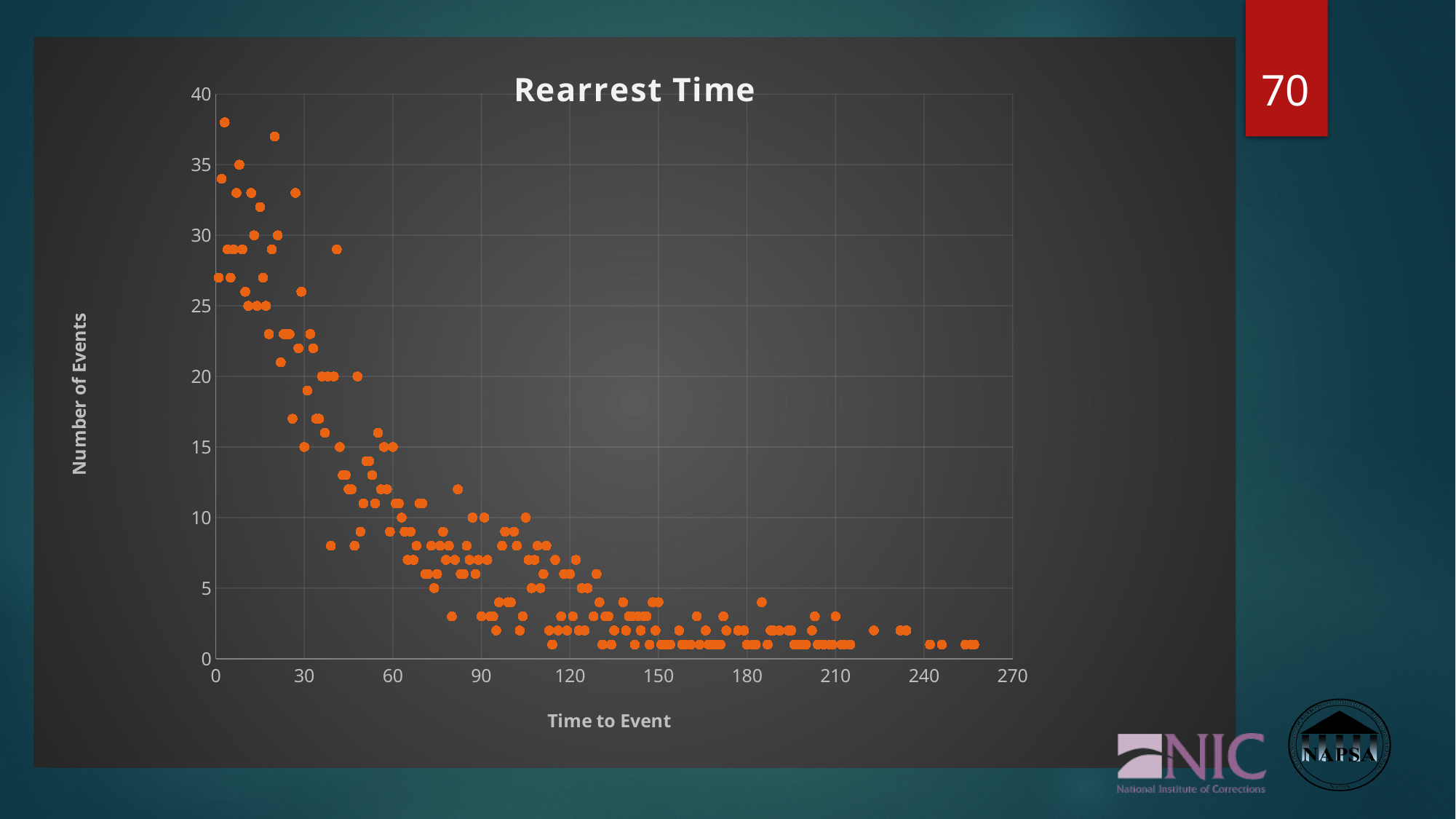
What is the title of the chart? Rearrest Time Is the highest plotted Number of Events greater or less than 35? greater What is the label of the x axis? Time to Event Are the points plotted beyond a Time to Event of 150 greater or less than 5 on the Number of Events axis? less Is the Number of Events for the point at a Time to Event of about 40 with the highest value greater or less than 25? greater Which region of the x axis has the higher Number of Events values: near 0 or near 240? Near 0 Do the values on the y axis generally rise or fall as Time to Event increases? Fall What is the maximum value shown on the x axis? 270 What kind of chart is shown on the slide? Scatter chart